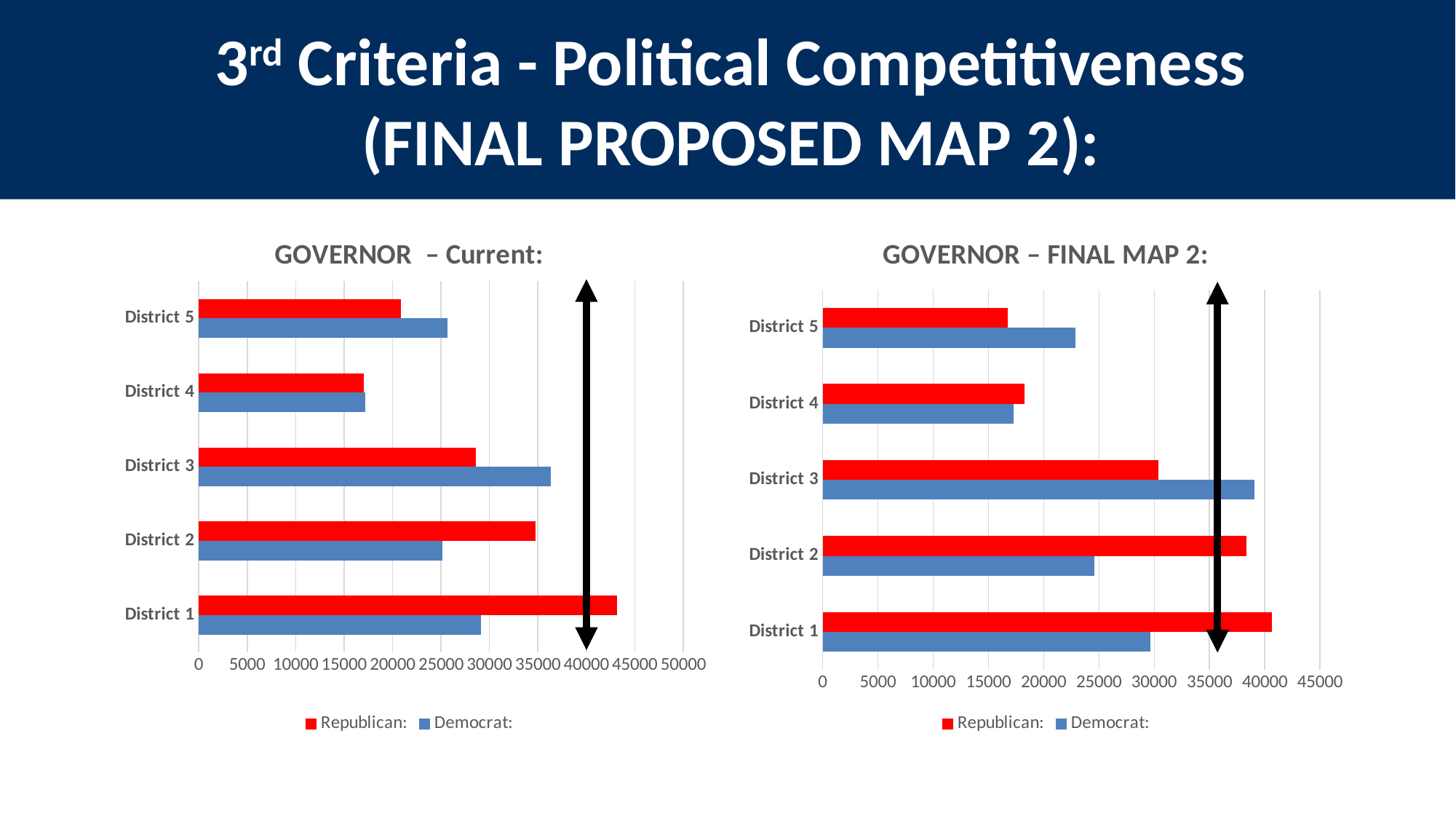
In the 'GOVERNOR – FINAL MAP 2:' chart, is the Democrat value for District 3 greater or less than 35000? greater What kind of chart is the 'GOVERNOR – Current:' chart? bar chart How many series does the legend of the 'GOVERNOR – FINAL MAP 2:' chart list? 2 In the 'GOVERNOR – FINAL MAP 2:' chart, is the Republican value for District 5 greater or less than 20000? less In the 'GOVERNOR – FINAL MAP 2:' chart, which district has the highest Democrat value? District 3 In the 'GOVERNOR – FINAL MAP 2:' chart, which is larger for District 2, the Republican or the Democrat value? Republican In the 'GOVERNOR – Current:' chart, which district has the lowest Republican value? District 4 What colour represents the Republican series in the 'GOVERNOR – Current:' chart? red In the 'GOVERNOR – Current:' chart, is the Republican value for District 1 greater or less than 40000? greater In the 'GOVERNOR – Current:' chart, which district has the highest Republican value? District 1 How many districts are shown on the 'GOVERNOR – Current:' chart? 5 In the 'GOVERNOR – Current:' chart, which is larger for District 3, the Republican or the Democrat value? Democrat